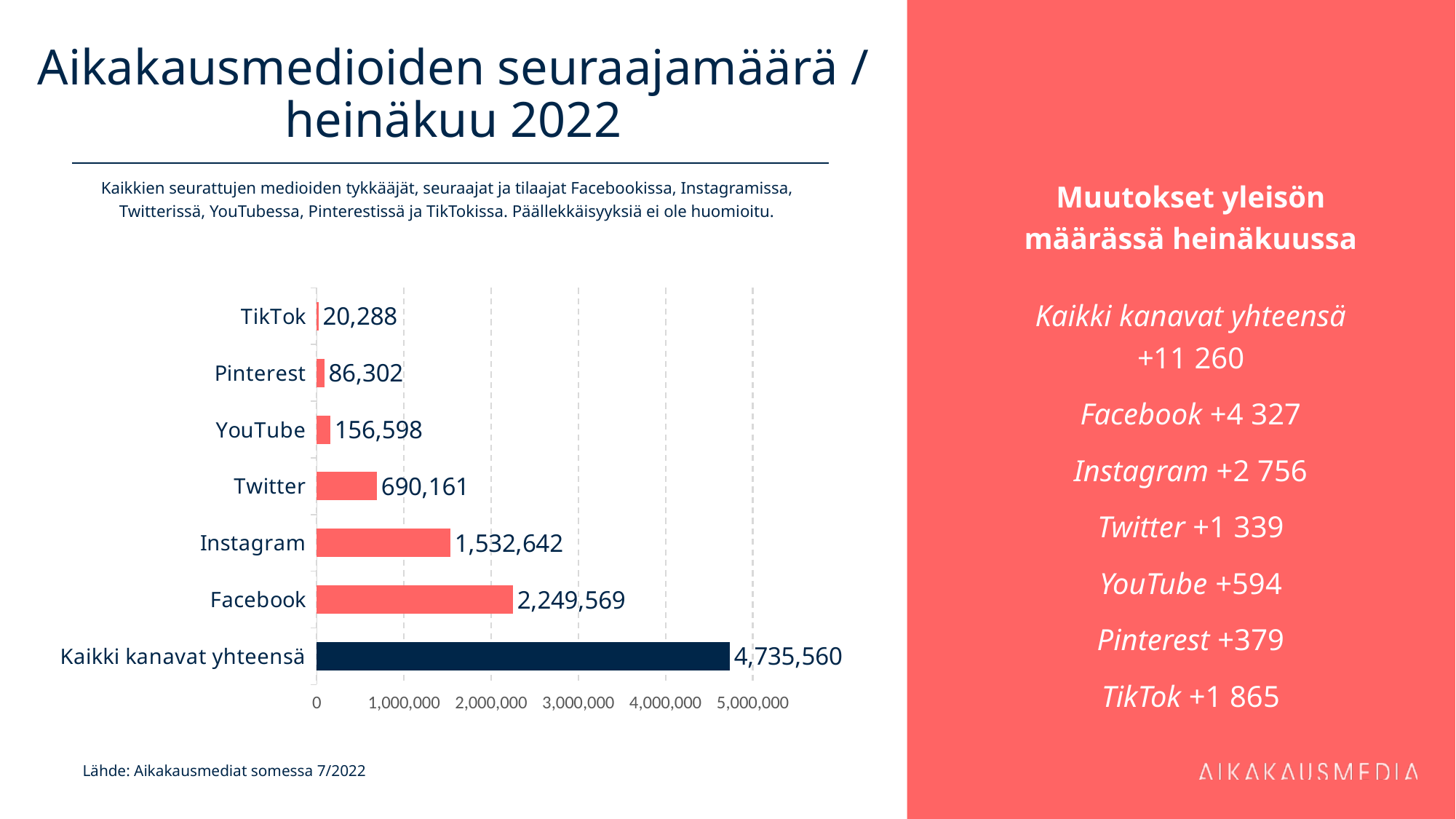
Which category has the lowest value? TikTok What is the difference between the values for Twitter and YouTube? 533,563 Which category has the highest value? Kaikki kanavat yhteensä Which is larger, the value for Twitter or the value for YouTube? Twitter How many categories are shown in the chart? 7 Is the value for Facebook greater or less than 2,000,000? greater What is the value for Kaikki kanavat yhteensä? 4,735,560 What kind of chart is shown on the slide? Bar chart What is the difference between the values for Facebook and Instagram? 716,927 What is the value for TikTok? 20,288 What is the value for Facebook? 2,249,569 What is the value for Instagram? 1,532,642